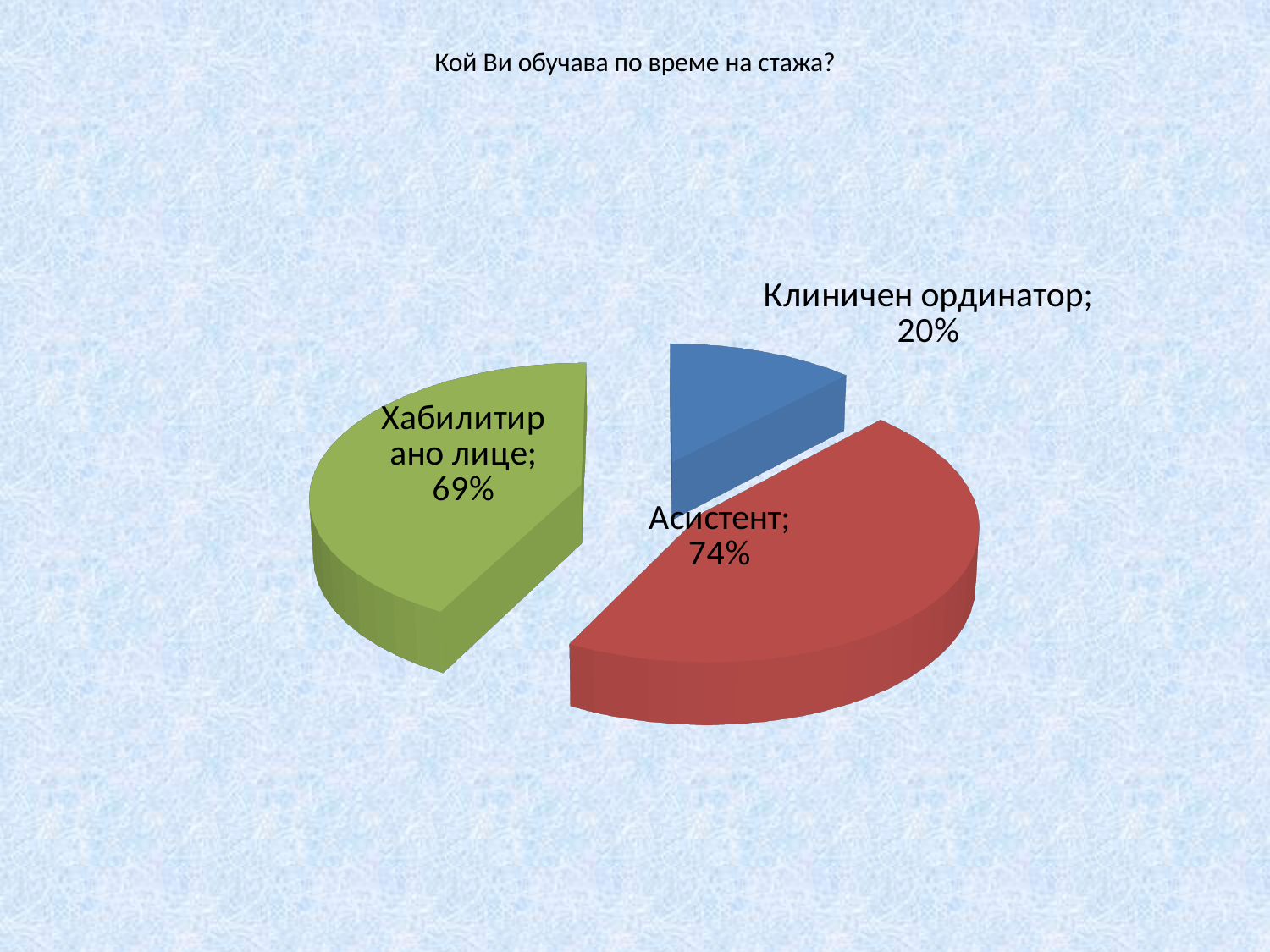
Which category has the largest slice? Асистент What colour is the slice for Асистент? red How many slices does the pie chart have? 3 What is the difference in percentage points between Асистент and Клиничен ординатор? 54 What is the difference in percentage points between Асистент and Хабилитирано лице? 5 What percentage is shown for Хабилитирано лице? 69% What kind of chart is shown on the slide? pie chart What percentage is shown for Асистент? 74% Which is larger, the value for Хабилитирано лице or the value for Клиничен ординатор? Хабилитирано лице What percentage is shown for Клиничен ординатор? 20% What is the title of the chart? Кой Ви обучава по време на стажа? Which category has the smallest slice? Клиничен ординатор